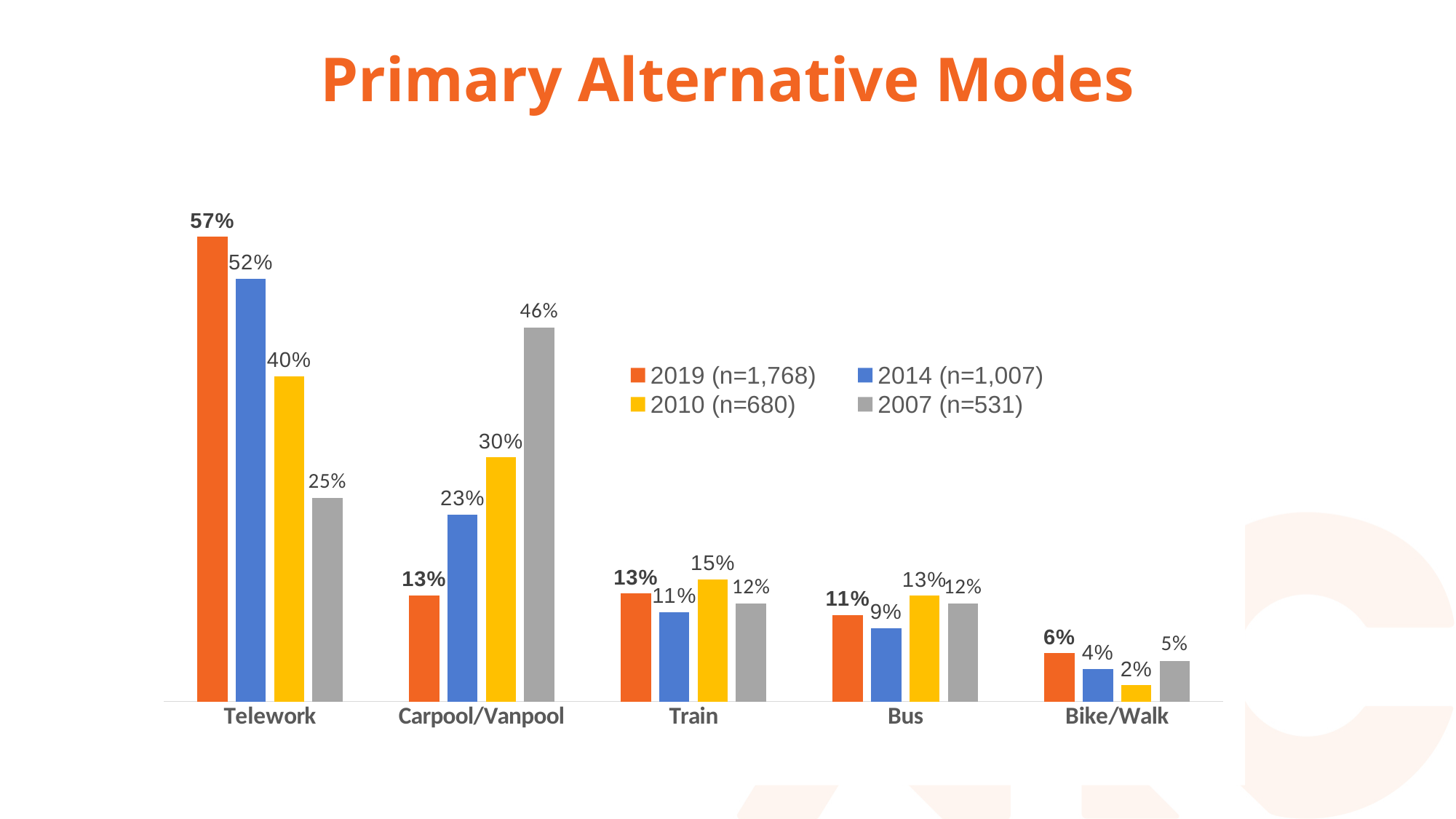
Which category has the lowest 2007 (n=531) value? Bike/Walk What is the 2019 (n=1,768) value for Telework? 57% How many categories are shown on the x axis? 5 What kind of chart is shown on the slide? Bar chart What is the difference between the 2019 and 2007 values for Telework? 32% What is the 2010 (n=680) value for Bike/Walk? 2% How many series does the legend list? 4 What is the 2014 (n=1,007) value for Bus? 9% Which is larger for Carpool/Vanpool: the 2010 (n=680) value or the 2014 (n=1,007) value? 2010 (n=680) Which category has the highest 2019 (n=1,768) value? Telework What is the title of the chart? Primary Alternative Modes What is the 2007 (n=531) value for Carpool/Vanpool? 46%